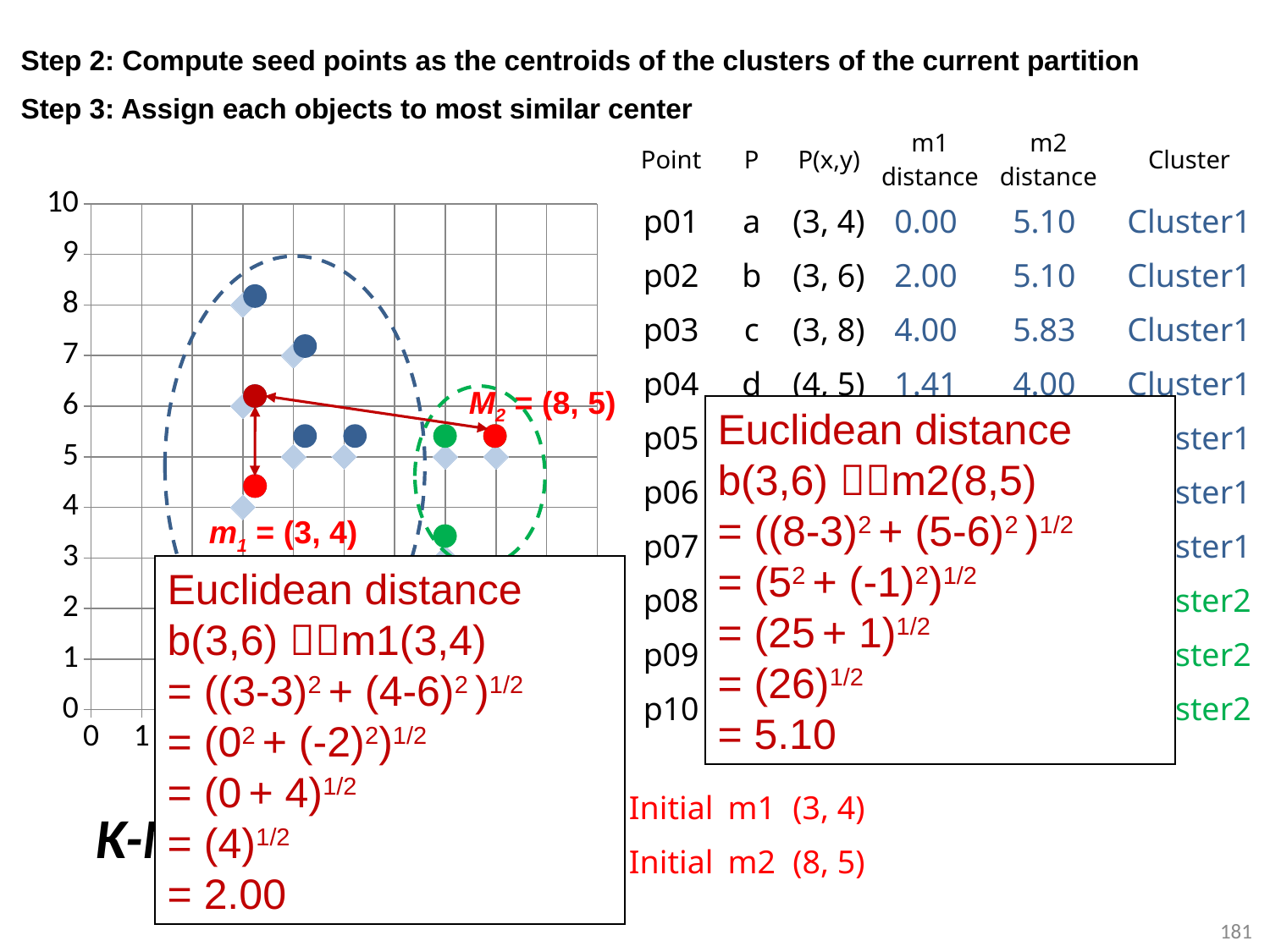
Is the y coordinate of seed point M2 greater or less than 4? greater What are the coordinates of the seed point labelled m1 on the chart? (3, 4) What are the coordinates of the seed point labelled M2 on the chart? (8, 5) What is the difference between the x coordinates of M2 and m1? 5 What is the difference between the y coordinates of M2 and m1? 1 What colour is the dashed ellipse drawn around the seed point M2? green Which seed point has the larger x coordinate, m1 or M2? M2 What kind of chart is shown on the left of the slide? scatter chart Is the y coordinate of seed point m1 greater or less than 5? less What is the highest value shown on the y axis of the chart? 10